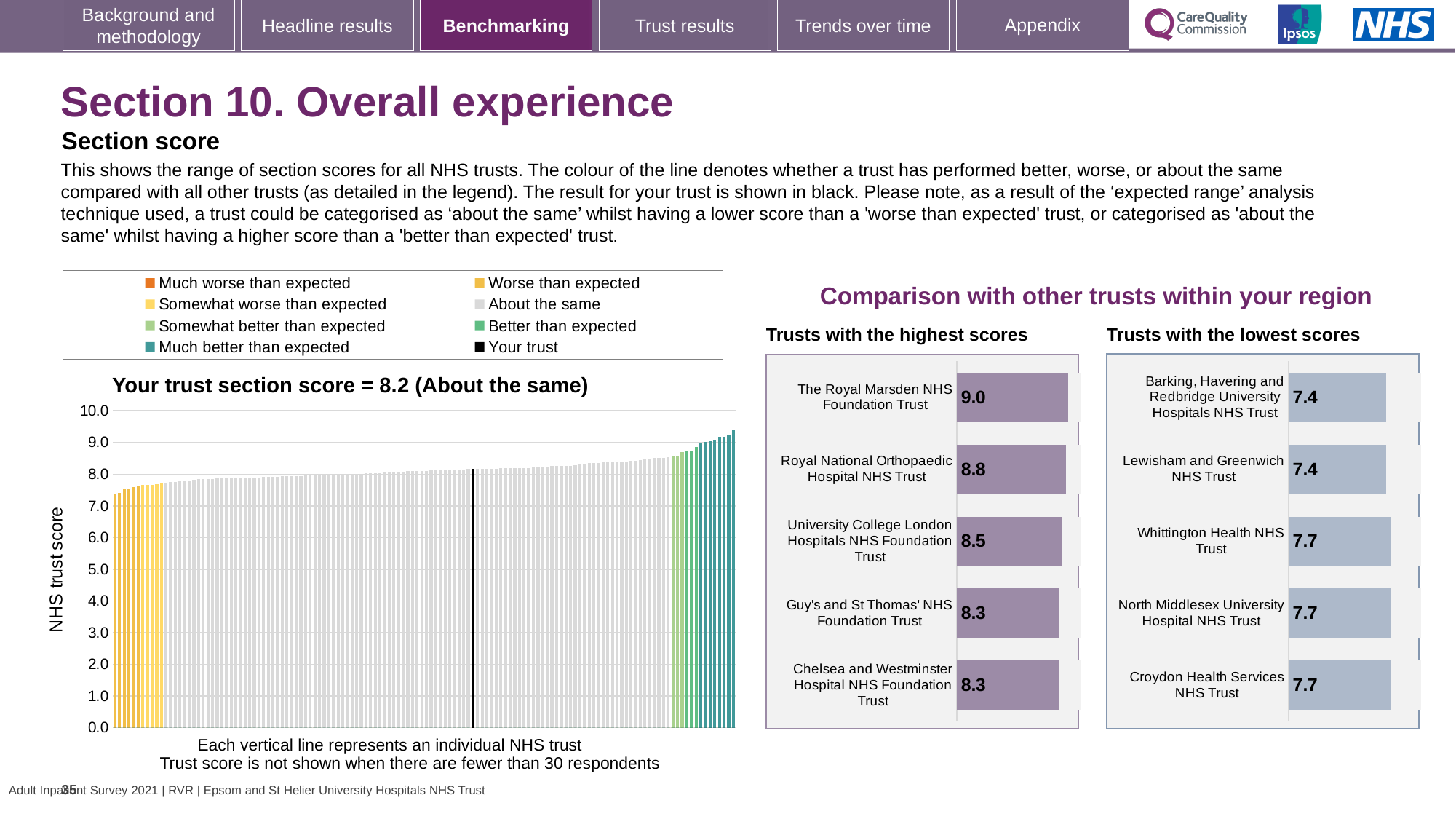
In the 'Trusts with the highest scores' chart, what is the difference between the scores of The Royal Marsden NHS Foundation Trust and University College London Hospitals NHS Foundation Trust? 0.5 In the 'Trusts with the highest scores' chart, what is the score for The Royal Marsden NHS Foundation Trust? 9.0 In the 'Trusts with the lowest scores' chart, what is the score for Whittington Health NHS Trust? 7.7 In the 'Trusts with the lowest scores' chart, which has the larger score: Barking, Havering and Redbridge University Hospitals NHS Trust or Croydon Health Services NHS Trust? Croydon Health Services NHS Trust How many entries does the legend above the 'Your trust section score' chart list? 8 What kind of chart is the 'Your trust section score' chart? bar chart What is the y-axis label of the 'Your trust section score' chart? NHS trust score In the 'Your trust section score' chart, is the value of the leftmost bar greater or less than 8.0? less In the 'Trusts with the highest scores' chart, how many trusts are shown? 5 In the 'Your trust section score' chart, do the bars rise or fall from left to right? rise In the 'Your trust section score' chart, is the value of the rightmost bar greater or less than 9.0? greater In the 'Your trust section score' chart, what is the section score for your trust? 8.2